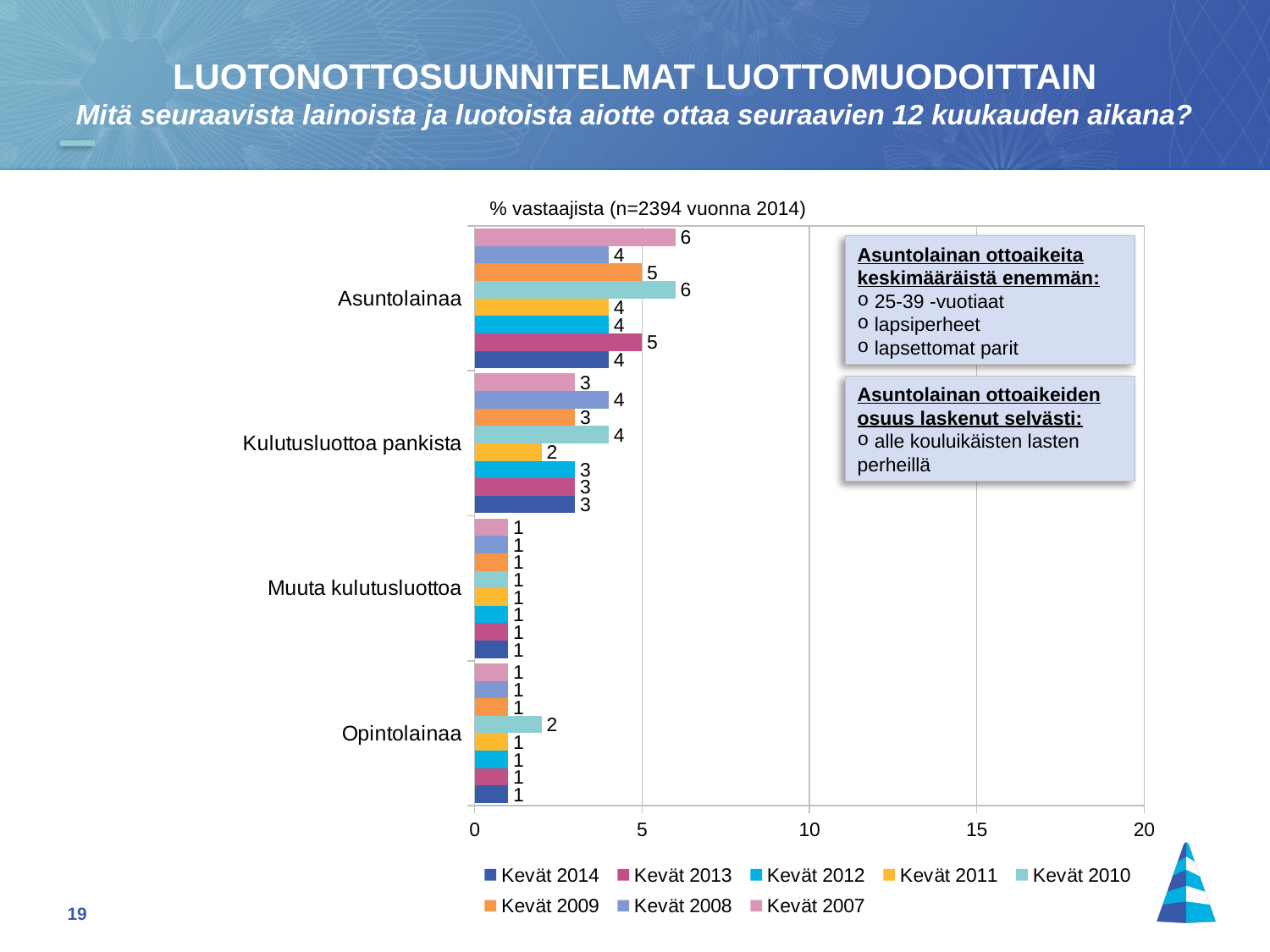
How many loan categories are shown on the chart? 4 What is the difference between the Asuntolainaa values for Kevät 2010 and Kevät 2014? 2 What is the value for Asuntolainaa in Kevät 2014? 4 Is the value for Asuntolainaa in Kevät 2007 greater or less than 5? greater What is the axis label shown above the chart? % vastaajista (n=2394 vuonna 2014) What is the value for Muuta kulutusluottoa in Kevät 2014? 1 What is the value for Opintolainaa in Kevät 2010? 2 Which is larger for Kevät 2013: Asuntolainaa or Kulutusluottoa pankista? Asuntolainaa What kind of chart is shown on the slide? bar chart What is the value for Kulutusluottoa pankista in Kevät 2011? 2 Which category has the highest value in Kevät 2014? Asuntolainaa How many series does the legend list? 8